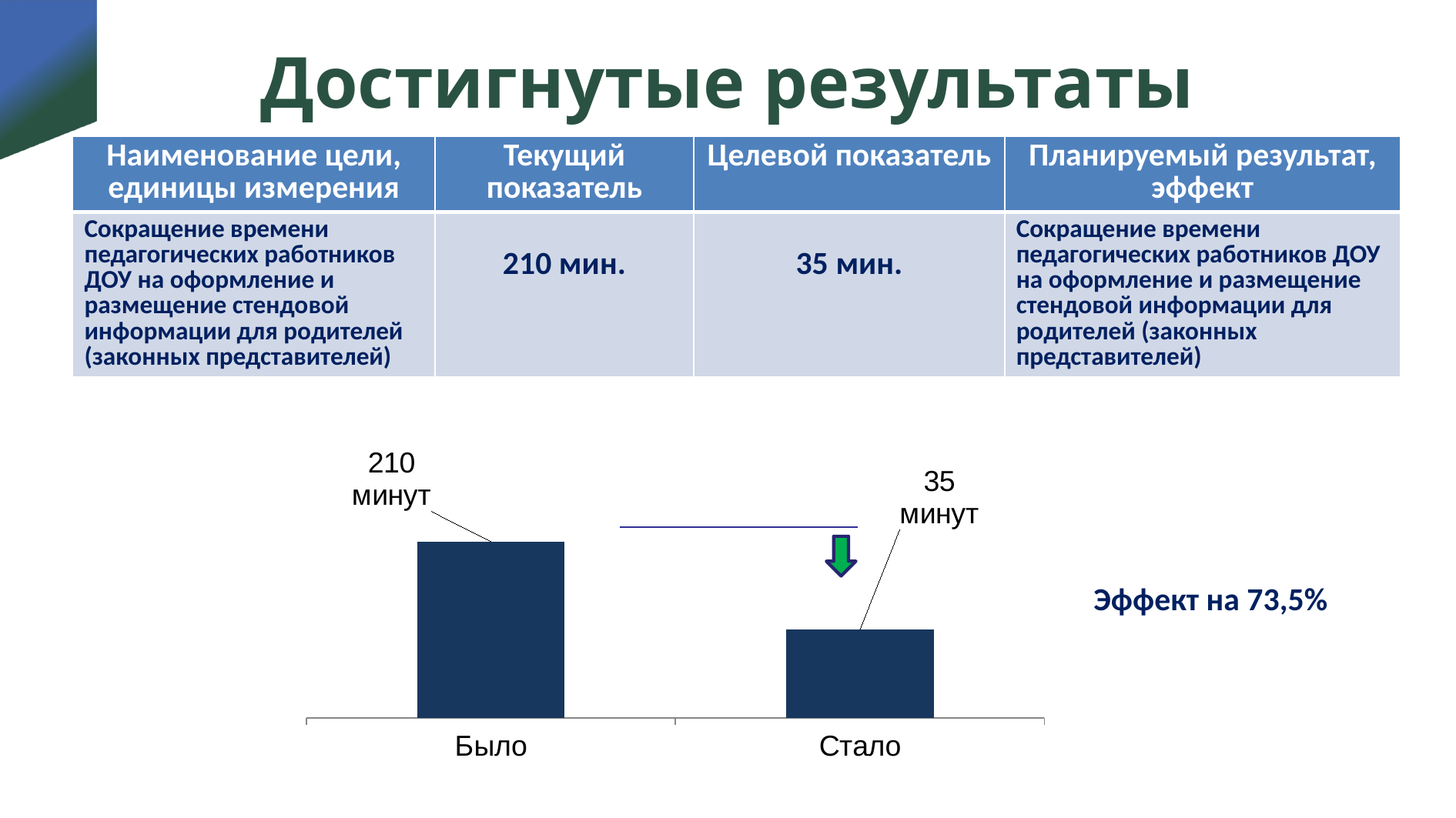
How many categories are shown in the bar chart? 2 Do the values in the bar chart rise or fall from "Было" to "Стало"? Fall Which category has the highest value in the bar chart? Было What is the value for "Было" in the bar chart? 210 минут Which is larger in the bar chart, the value for "Было" or the value for "Стало"? Было What is the difference between the values for "Было" and "Стало" in the bar chart? 175 минут What are the category labels on the x axis of the bar chart? Было, Стало Which category has the lowest value in the bar chart? Стало What kind of chart is shown on the slide? Bar chart What effect percentage is stated next to the bar chart? Эффект на 73,5% What is the value for "Стало" in the bar chart? 35 минут